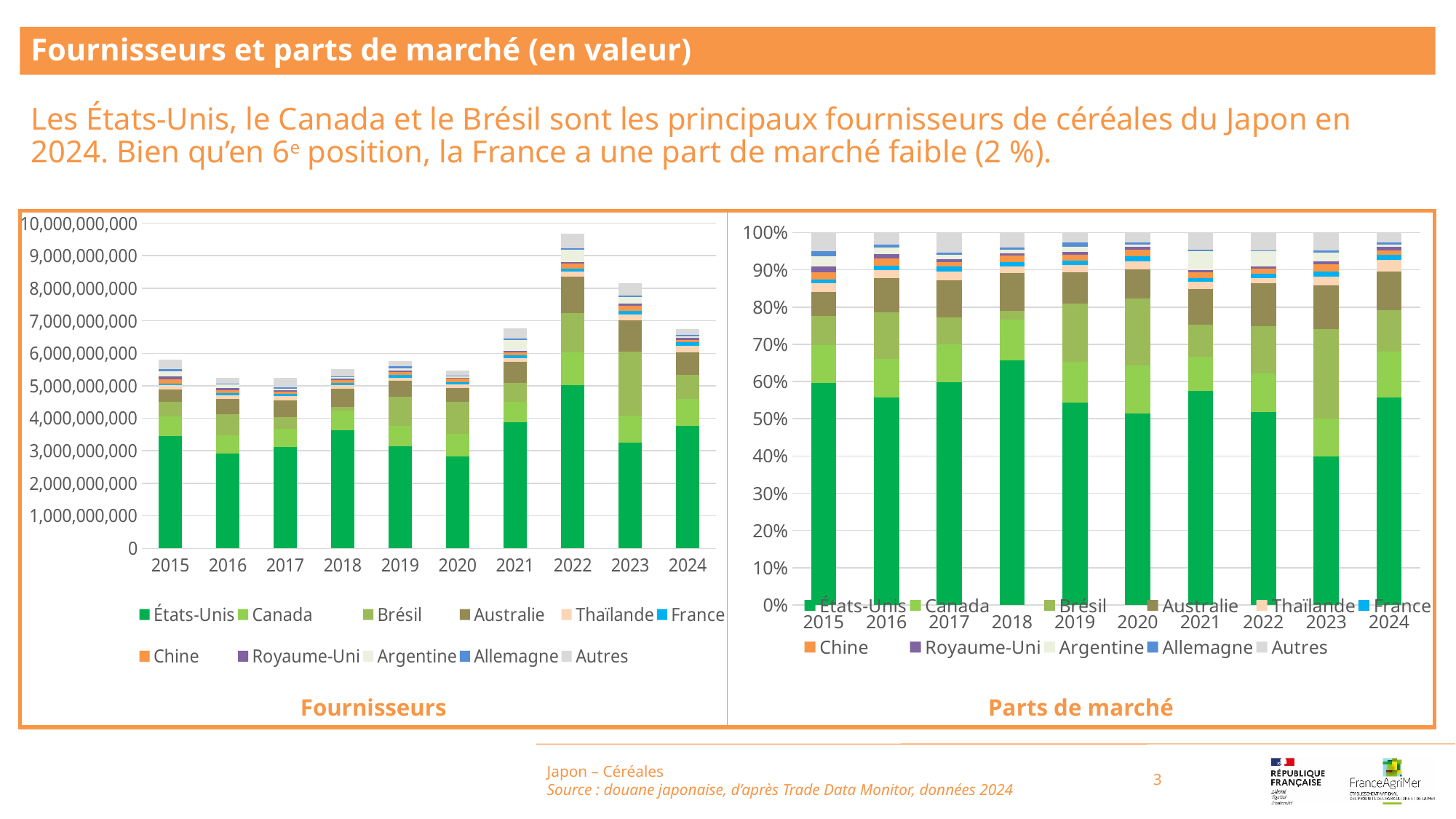
In the 'Fournisseurs' chart, which year has the highest total bar? 2022 How many years are shown on the x axis of the 'Parts de marché' chart? 10 In the 'Fournisseurs' chart, is the total for 2024 greater or less than 7,000,000,000? less In the 'Fournisseurs' chart, is the États-Unis value for 2022 greater or less than 4,000,000,000? greater In the 'Parts de marché' chart, is the États-Unis share for 2023 greater or less than 50%? less How many series does the legend of the 'Fournisseurs' chart list? 11 In the 'Fournisseurs' chart, which total bar is larger, 2015 or 2016? 2015 In the 'Parts de marché' chart, which year has the highest share for États-Unis? 2018 In the 'Fournisseurs' chart, what colour represents États-Unis? Green What kind of chart is the 'Fournisseurs' chart on the left? Stacked bar chart In the 'Parts de marché' chart, which year has the lowest share for États-Unis? 2023